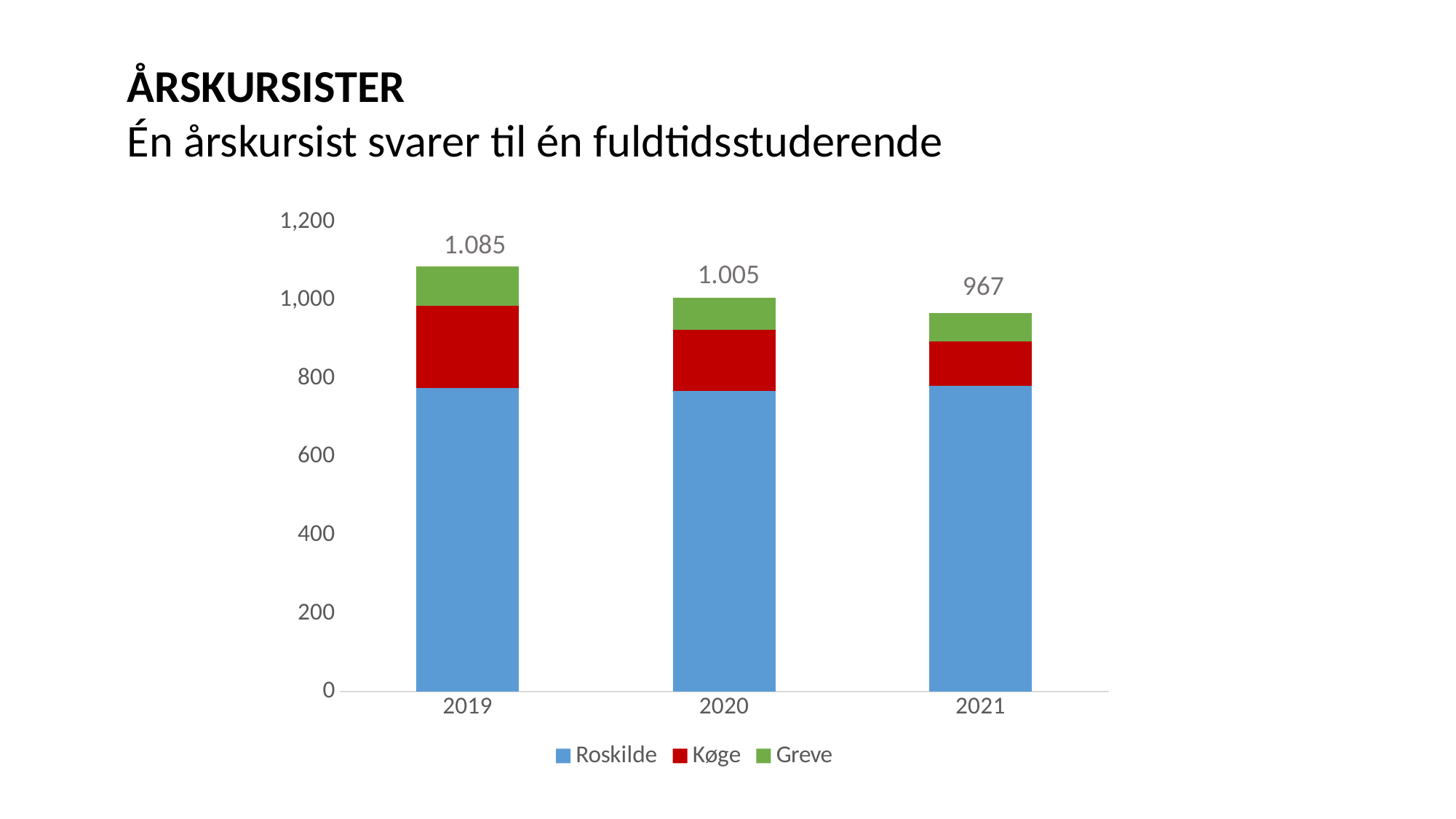
Which is larger, the total for 2020 or the total for 2021? 2020 Is the value for Roskilde in 2019 greater or less than 800? less What is the total number of årskursister shown for 2019? 1.085 Which year has the lowest total of årskursister? 2021 What is the difference between the total for 2019 and the total for 2020? 80 What is the total number of årskursister shown for 2021? 967 How many series does the legend list? 3 Which year has the highest total of årskursister? 2019 What kind of chart is shown on the slide? Stacked bar chart How many years are shown on the x axis? 3 Do the total values rise or fall from 2019 to 2021? fall What is the difference between the total for 2020 and the total for 2021? 38